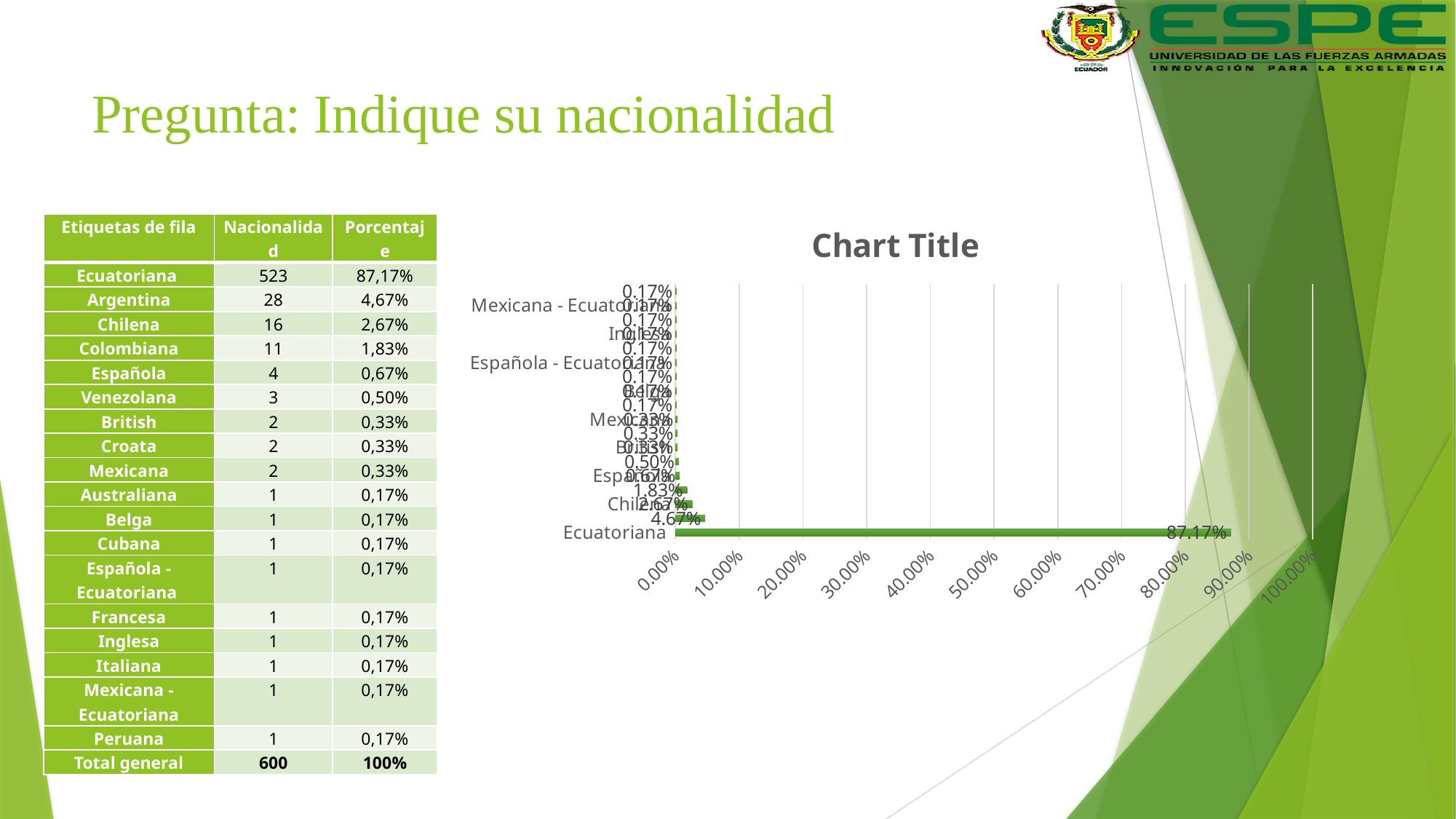
What value does the chart show for Ecuatoriana? 87.17% Is the value for Ecuatoriana greater or less than 80.00%? greater What is the highest value shown on the chart's horizontal axis? 100.00% Is the value for Mexicana - Ecuatoriana greater or less than 10.00%? less Which is larger, the value for Ecuatoriana or the value for Española? Ecuatoriana What is the title of the chart? Chart Title Which category has the highest value in the chart? Ecuatoriana Which is larger, the value for Ecuatoriana or the value for Inglesa? Ecuatoriana Is the value for Chilena greater or less than 10.00%? less What kind of chart is shown on the slide? bar chart